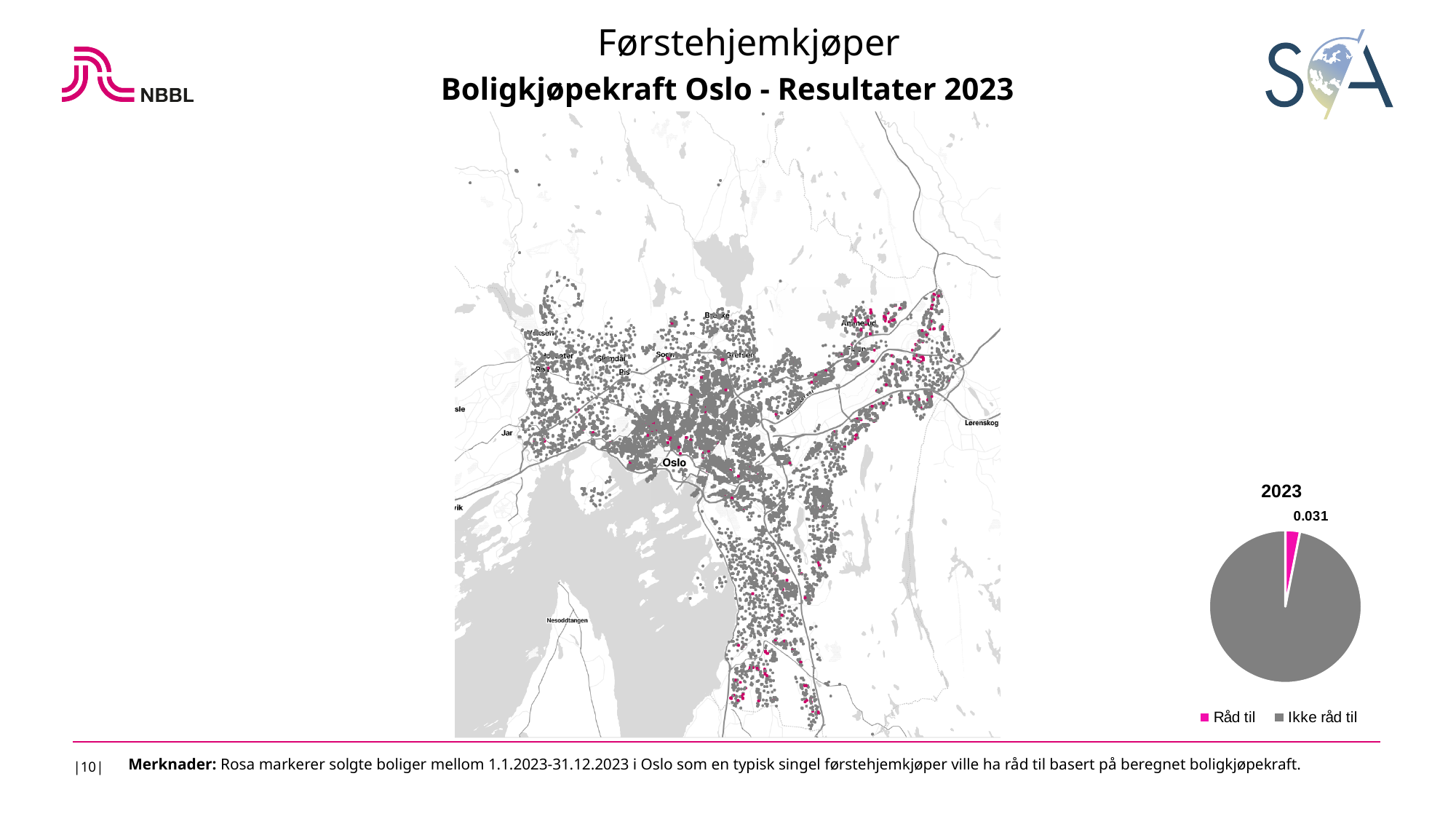
What colour is the 'Råd til' slice in the pie chart? pink In the pie chart, which is larger: 'Råd til' or 'Ikke råd til'? Ikke råd til In the pie chart, what share of the pie does the 'Råd til' slice represent? 0.031 What is the title of the pie chart? 2023 How many entries does the legend of the pie chart list? 2 Which slice of the pie chart is the largest? Ikke råd til How many slices does the pie chart have? 2 Which slice of the pie chart is the smallest? Råd til What kind of chart is shown on the right side of the slide? pie chart In the pie chart, what value is labelled on the 'Råd til' slice? 0.031